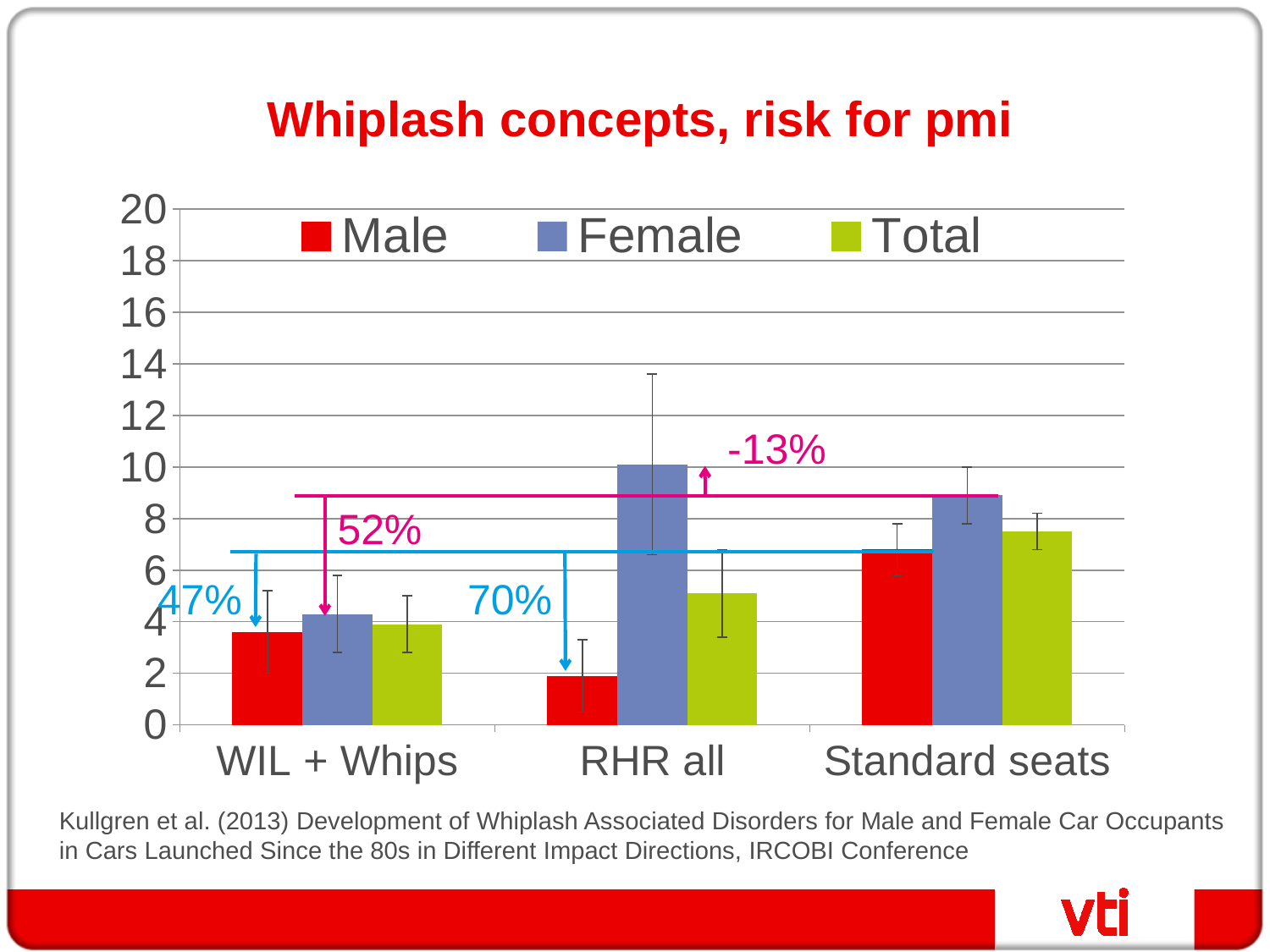
Is the Female value for RHR all greater or less than 8? greater Which category has the highest Total value? Standard seats What kind of chart is shown on the slide? bar chart How many categories are shown on the x axis of the chart? 3 Which series is shown in red in the chart? Male Is the Male value for RHR all greater or less than 4? less Which category has the highest Female value? RHR all Which category has the highest Male value? Standard seats How many series does the chart's legend list? 3 What is the title of the chart? Whiplash concepts, risk for pmi For RHR all, which is larger, the Male value or the Female value? Female Which category has the lowest Male value? RHR all